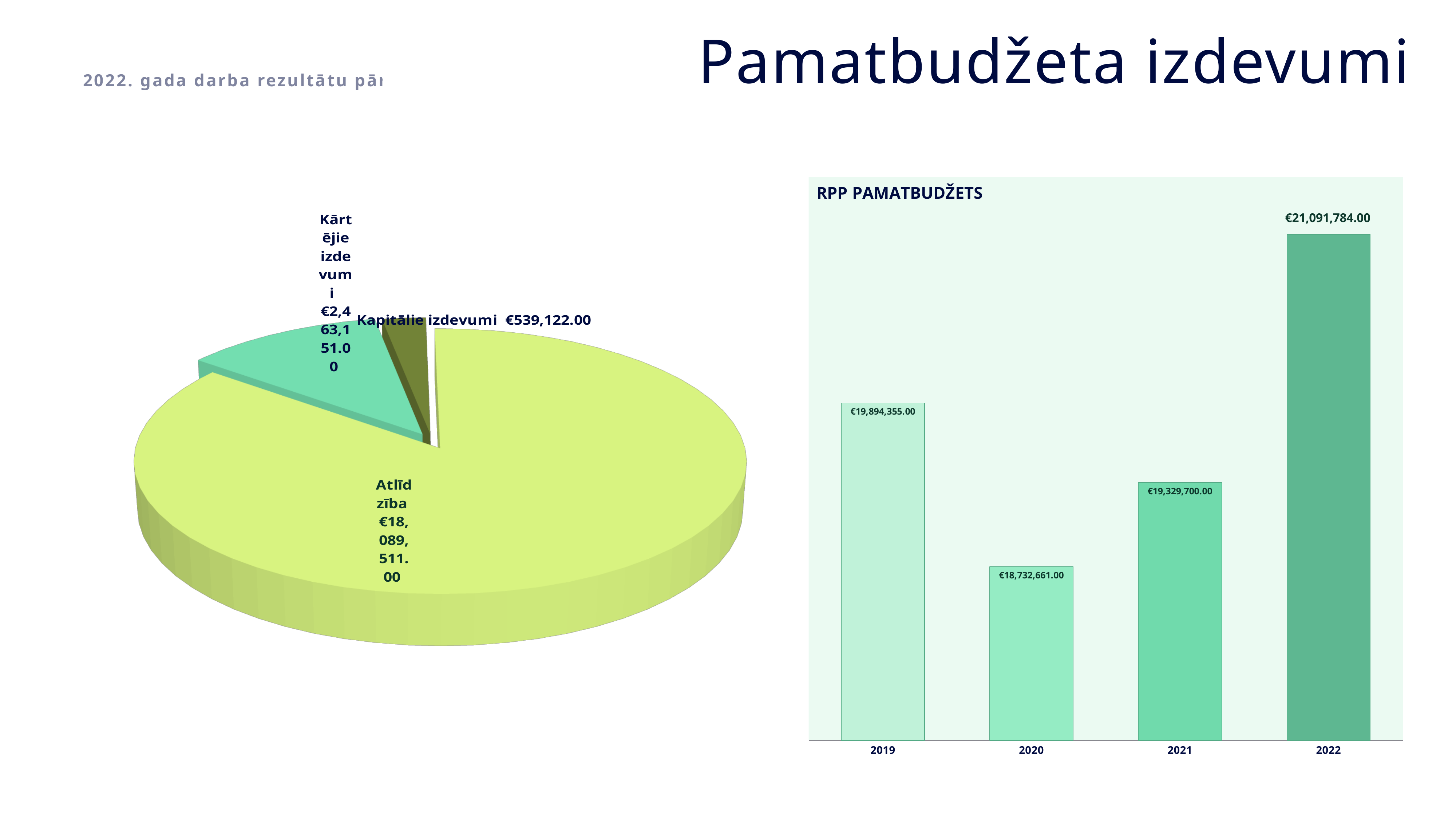
In the pie chart on the left, what is the difference between Kārtējie izdevumi and Kapitālie izdevumi? €1,924,029.00 In the pie chart on the left, what is the value for Kapitālie izdevumi? €539,122.00 In the bar chart titled RPP PAMATBUDŽETS, which year has the lowest value? 2020 In the bar chart titled RPP PAMATBUDŽETS, which year has the highest value? 2022 In the bar chart titled RPP PAMATBUDŽETS, what is the value for 2022? €21,091,784.00 In the bar chart titled RPP PAMATBUDŽETS, which is larger, the value for 2019 or the value for 2021? 2019 What kind of chart is the chart on the right side of the slide? Bar chart In the pie chart on the left, what is the value for Atlīdzība? €18,089,511.00 In the bar chart titled RPP PAMATBUDŽETS, what is the difference between the 2022 and 2019 values? €1,197,429.00 In the pie chart on the left, which category has the smallest slice? Kapitālie izdevumi In the bar chart titled RPP PAMATBUDŽETS, how many years are shown? 4 In the bar chart titled RPP PAMATBUDŽETS, what is the value for 2020? €18,732,661.00